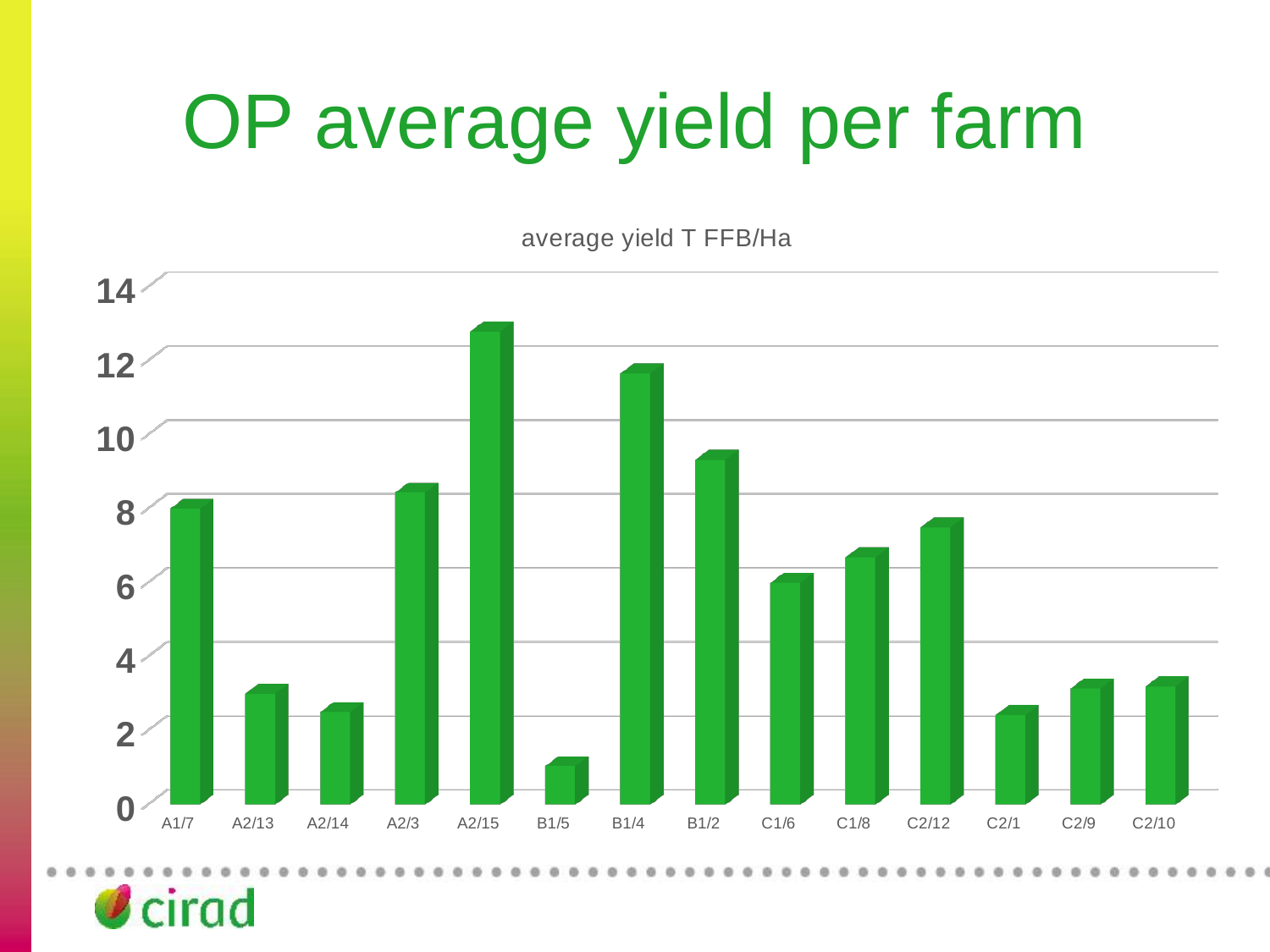
What is the title printed above the chart? average yield T FFB/Ha Is the value for B1/5 greater or less than 2? less Which farm has the highest average yield? A2/15 Which has the larger average yield, A2/15 or B1/4? A2/15 What kind of chart is shown on the slide? bar chart Which has the larger average yield, B1/2 or C1/6? B1/2 Which farm has the lowest average yield? B1/5 Is the value for C2/12 greater or less than 8? less Is the value for A2/13 greater or less than 4? less How many farms (categories) are plotted on the x axis? 14